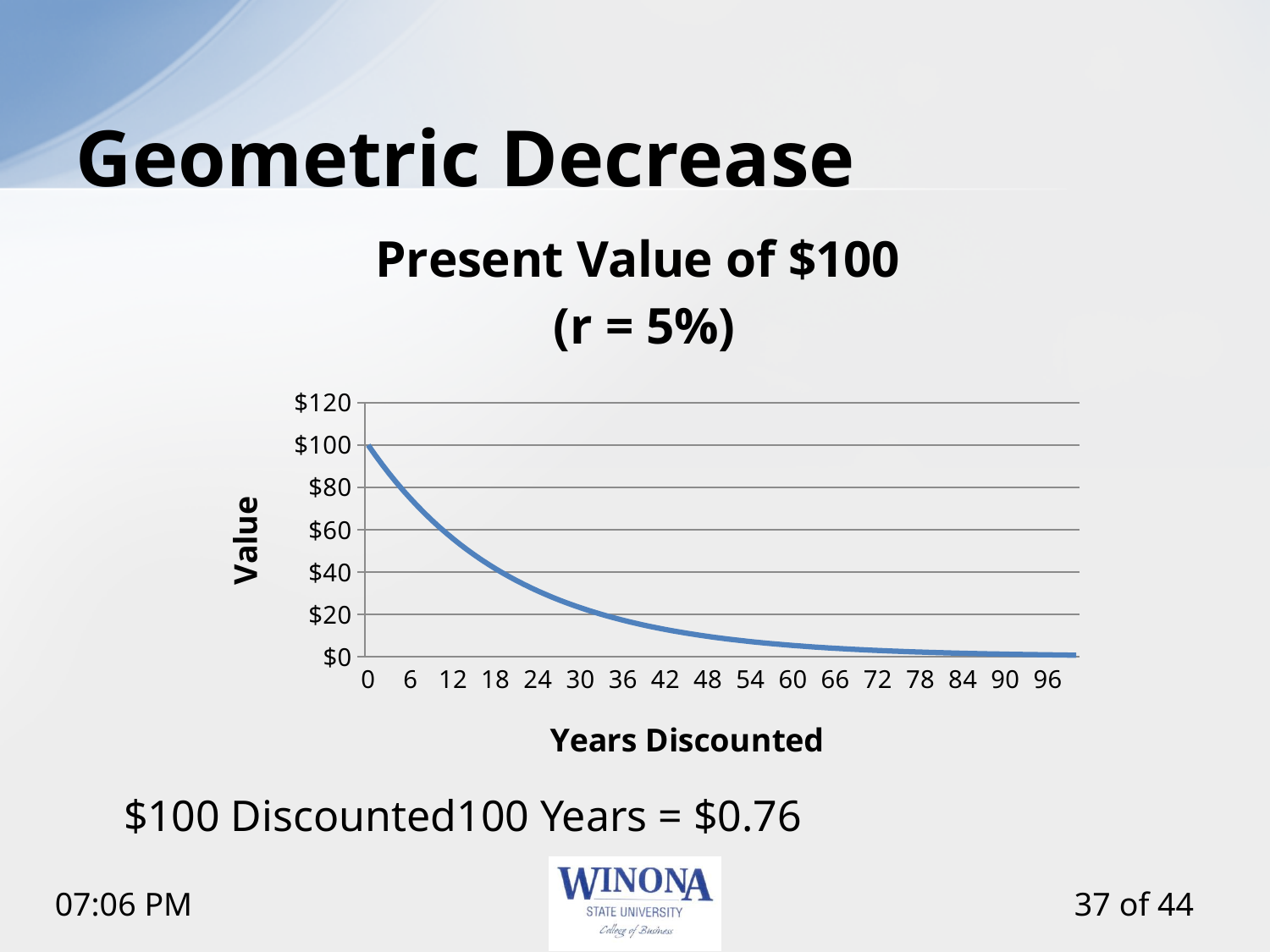
Which is larger, the value at 6 years discounted or the value at 48 years discounted? 6 years discounted What is the value at 0 years discounted? $100 Do the values rise or fall as the years discounted increase along the x axis? fall How many tick labels are shown on the x axis? 17 What is the label of the x axis of the chart? Years Discounted At which number of years discounted is the value highest? 0 What is the title of the chart? Present Value of $100 (r = 5%) What is the highest tick value shown on the y axis? $120 What kind of chart is shown on the slide? line chart Is the value at 30 years discounted greater or less than $40? less Is the value at 60 years discounted greater or less than $20? less Is the value at 12 years discounted greater or less than $40? greater